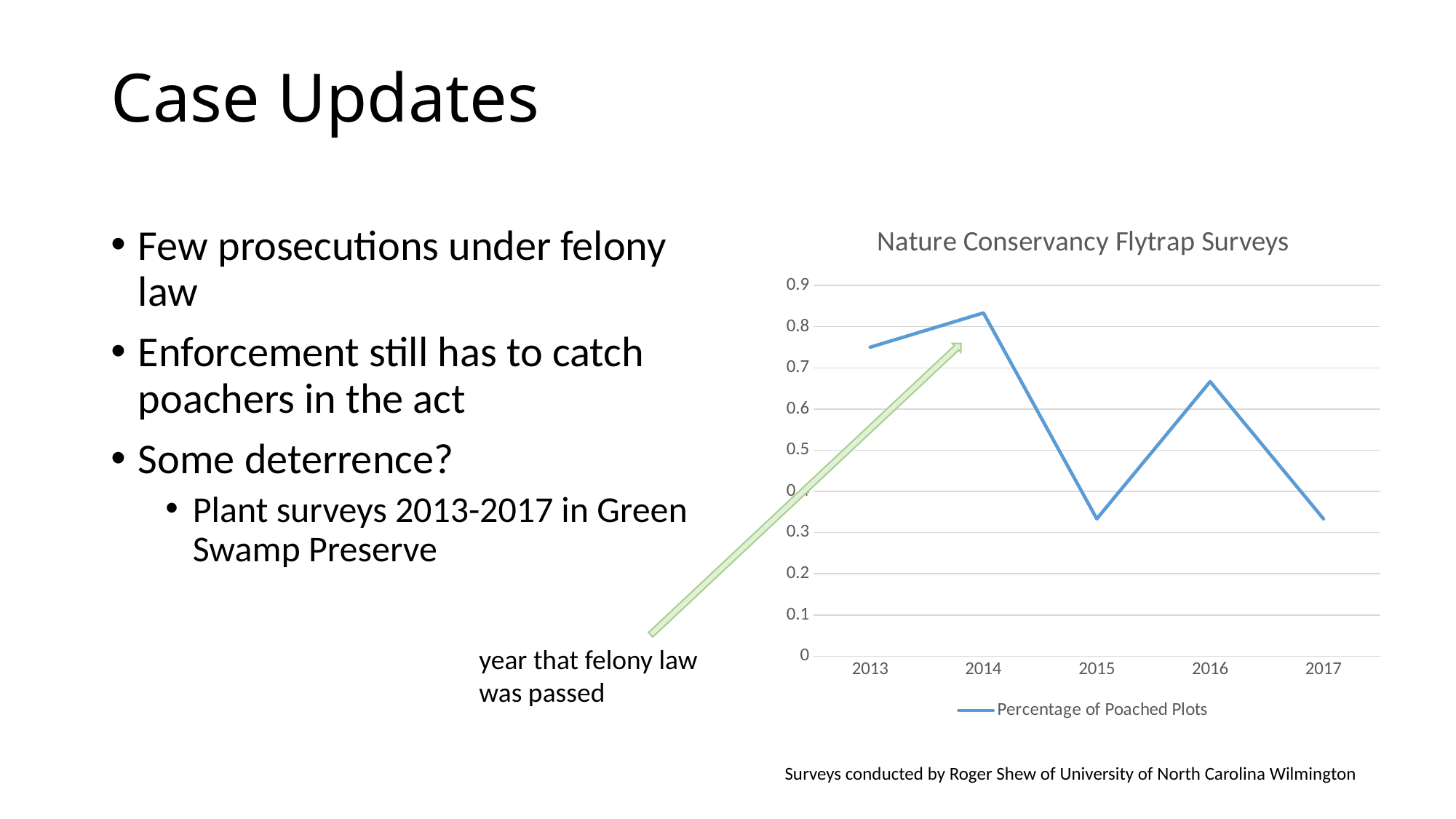
What is the title of the chart? Nature Conservancy Flytrap Surveys Which year has a higher Percentage of Poached Plots, 2014 or 2015? 2014 How many years are plotted on the x axis of the chart? 5 Which year has the highest Percentage of Poached Plots? 2014 What series name is shown in the chart legend? Percentage of Poached Plots Is the Percentage of Poached Plots for 2013 greater or less than 0.7? greater Is the Percentage of Poached Plots for 2016 greater or less than 0.6? greater Is the Percentage of Poached Plots for 2014 greater or less than 0.8? greater What type of chart is shown on the slide? line chart How many series does the chart legend list? 1 Does the Percentage of Poached Plots rise or fall from 2014 to 2015? fall